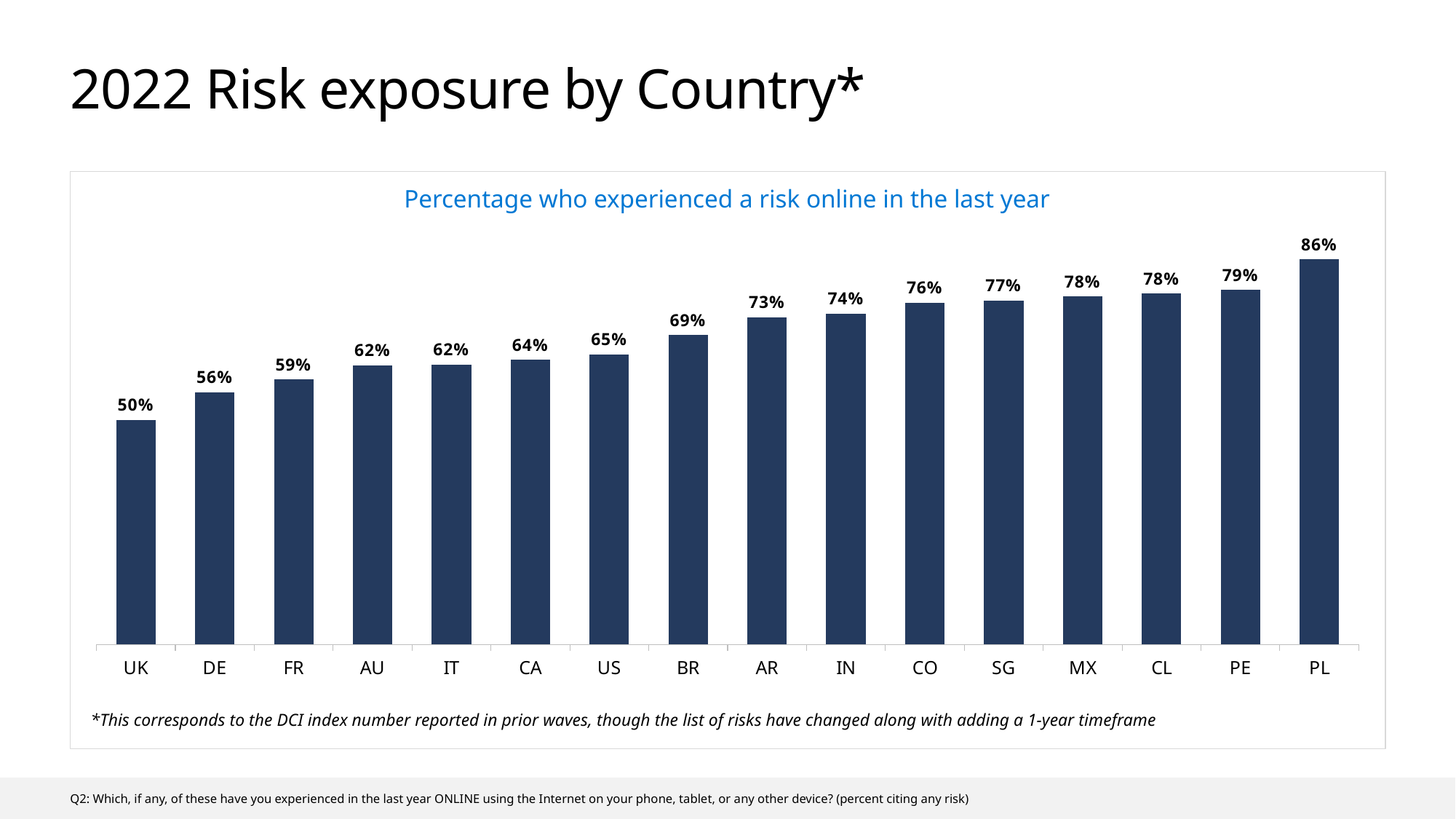
What type of chart is shown on the slide? Bar chart What is the difference between the values for IN and DE? 18% What is the value shown for MX? 78% What is the title of the chart? Percentage who experienced a risk online in the last year Which country has the lowest percentage who experienced a risk online? UK Do the values rise or fall moving from left to right along the x axis? Rise What is the value shown for BR? 69% What percentage of respondents in the UK experienced a risk online in the last year? 50% Which has a higher value, CA or AR? AR How many countries are shown in the chart? 16 Which country has the highest percentage who experienced a risk online? PL What is the difference between the values for PL and UK? 36%